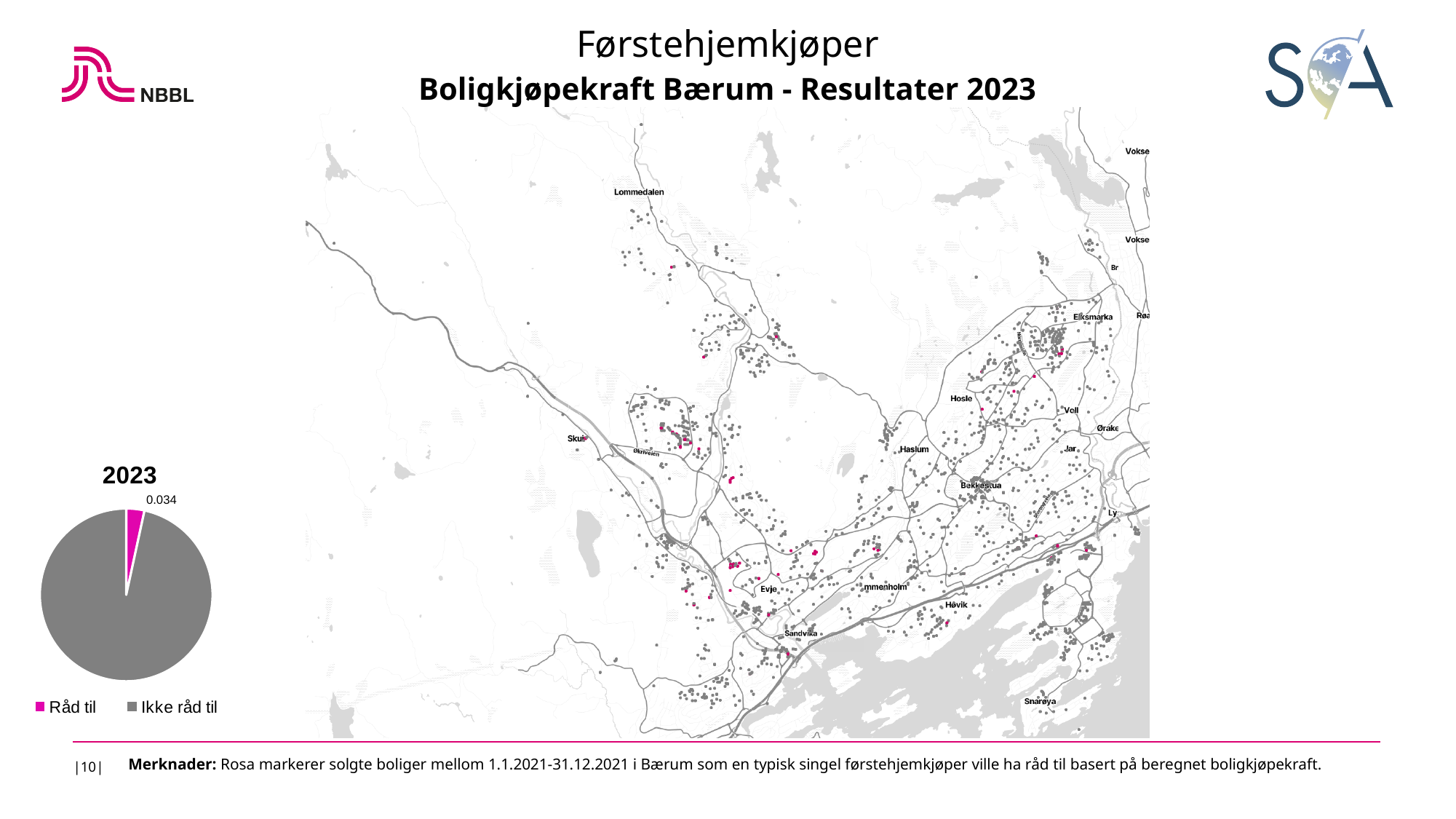
Which slice of the pie chart is the largest? Ikke råd til What colour is the "Råd til" slice in the pie chart? pink What is the title of the pie chart? 2023 Which slice of the pie chart is the smallest? Råd til In the pie chart, what value is labelled for the "Råd til" slice? 0.034 What share of the pie chart does the "Råd til" slice represent? 0.034 What kind of chart is shown on the left of the slide? pie chart In the pie chart, which is larger: "Råd til" or "Ikke råd til"? Ikke råd til How many entries does the legend of the pie chart list? 2 How many slices does the pie chart have? 2